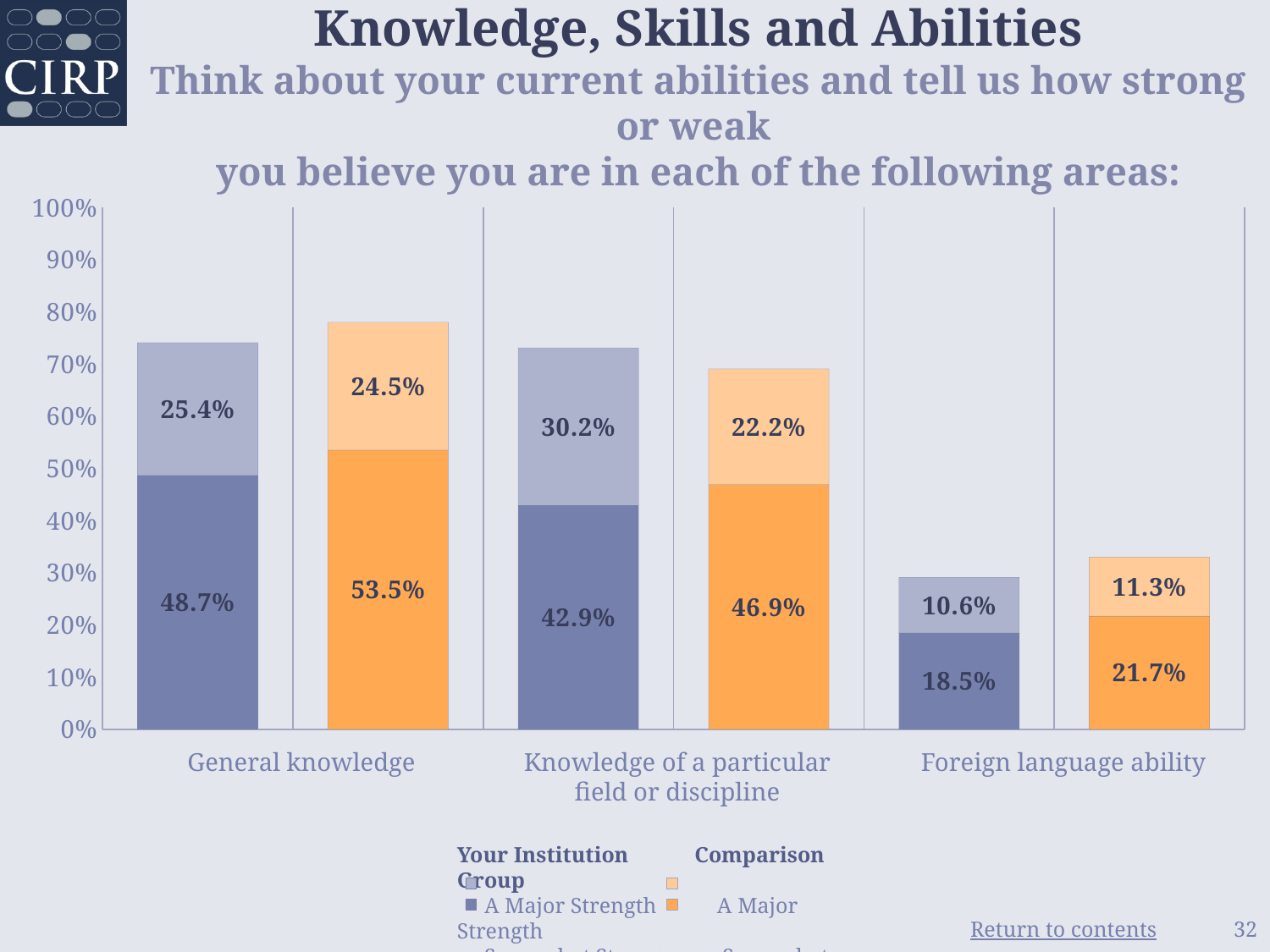
Which category has the lowest 'A Major Strength' value for Your Institution? Foreign language ability Which is larger for Knowledge of a particular field or discipline: the 'A Major Strength' value for Your Institution or for the Comparison Group? Comparison Group How many categories are shown on the x axis? 3 What type of chart is shown on the slide? Stacked bar chart What is the value of the lighter upper segment of the Your Institution bar for Knowledge of a particular field or discipline? 30.2% What is the difference between the Comparison Group and Your Institution 'A Major Strength' values for General knowledge? 4.8% Which category has the highest 'A Major Strength' value for the Comparison Group? General knowledge What is the 'A Major Strength' value for Your Institution in General knowledge? 48.7% What is the total height of the Comparison Group stacked bar for General knowledge? 78.0% What is the 'A Major Strength' value for the Comparison Group in Foreign language ability? 21.7% What is the total height of the Your Institution stacked bar for Foreign language ability? 29.1% What is the value of the lighter upper segment of the Comparison Group bar for General knowledge? 24.5%